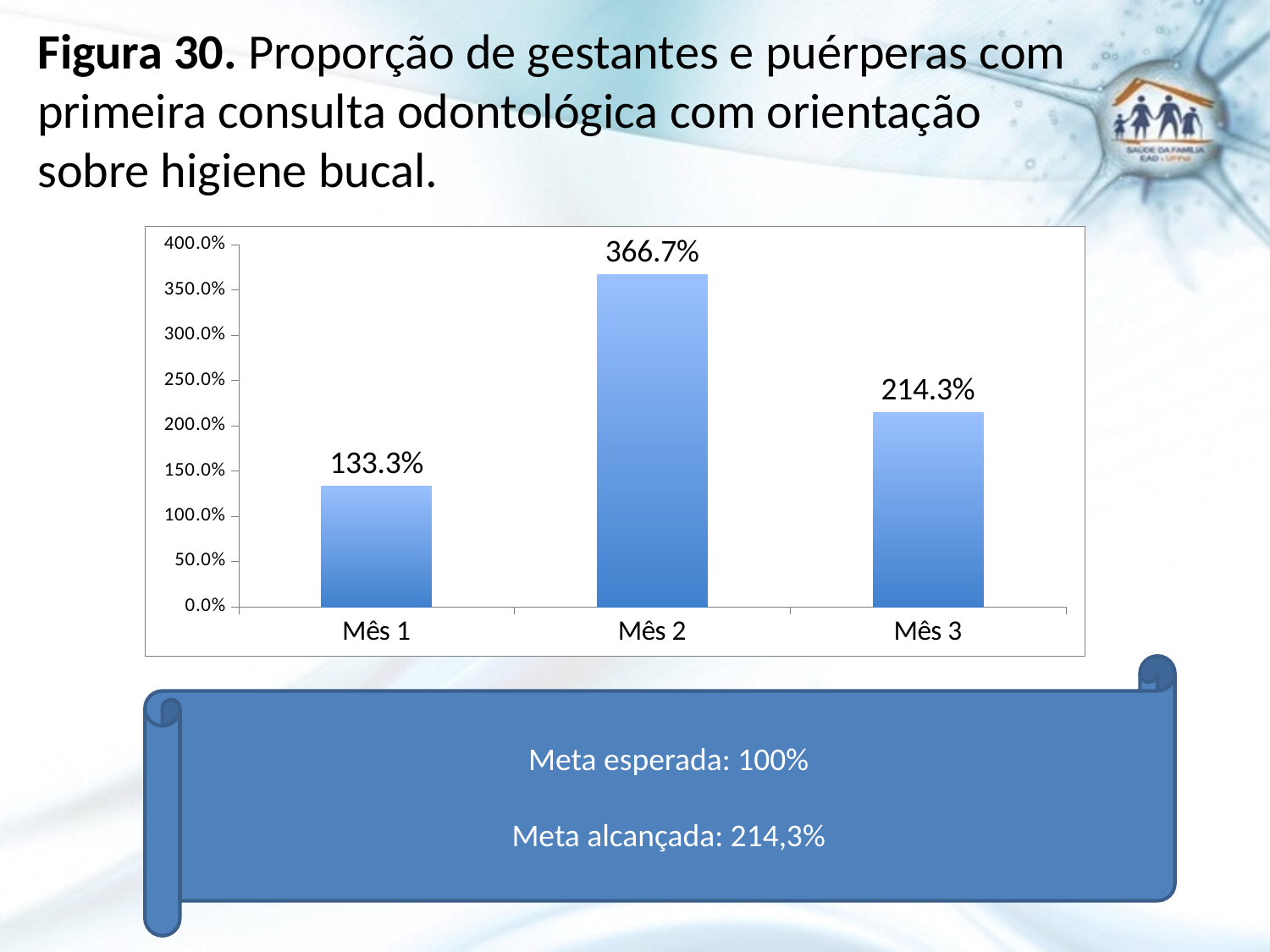
What kind of chart is shown on the slide? bar chart What is the value for Mês 3? 214.3% Which month has the highest value? Mês 2 Which is larger, the value for Mês 3 or the value for Mês 1? Mês 3 What is the value for Mês 2? 366.7% How many months are shown on the x axis? 3 What is the difference between the values for Mês 2 and Mês 1? 233.4% What is the value for Mês 1? 133.3% What is the maximum value shown on the y axis? 400.0% Which month has the lowest value? Mês 1 Is the value for Mês 3 greater or less than 200.0%? greater What is the difference between the values for Mês 2 and Mês 3? 152.4%